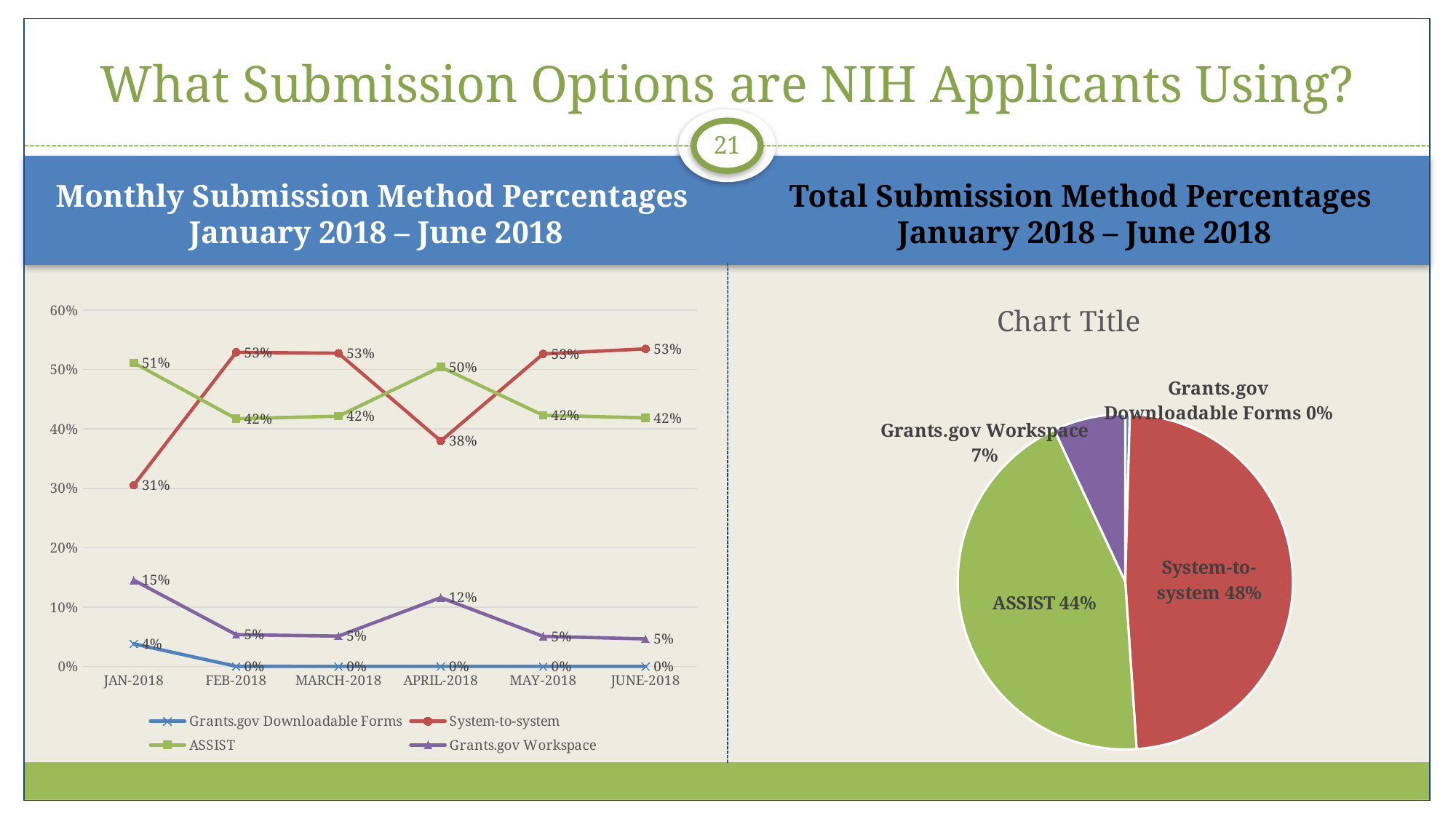
How many months are shown on the x axis of the Monthly Submission Method Percentages line chart? 6 In the Monthly Submission Method Percentages line chart, what is the value for ASSIST in APRIL-2018? 50% How many series does the legend of the Monthly Submission Method Percentages line chart list? 4 In the Monthly Submission Method Percentages line chart, what is the value for System-to-system in JAN-2018? 31% In the Monthly Submission Method Percentages line chart, in which month is the Grants.gov Workspace value highest? JAN-2018 In the Monthly Submission Method Percentages line chart, in which month is the System-to-system value lowest? JAN-2018 In the pie chart on the right, which submission method has the largest share? System-to-system In the Monthly Submission Method Percentages line chart, what is the value for Grants.gov Workspace in JAN-2018? 15% In the Monthly Submission Method Percentages line chart, what is the difference between the ASSIST and System-to-system values in JAN-2018? 20% In the Monthly Submission Method Percentages line chart, which is larger in APRIL-2018: ASSIST or System-to-system? ASSIST In the pie chart on the right, what share does ASSIST have? 44% What kind of chart is shown on the right side of the slide under Total Submission Method Percentages? Pie chart